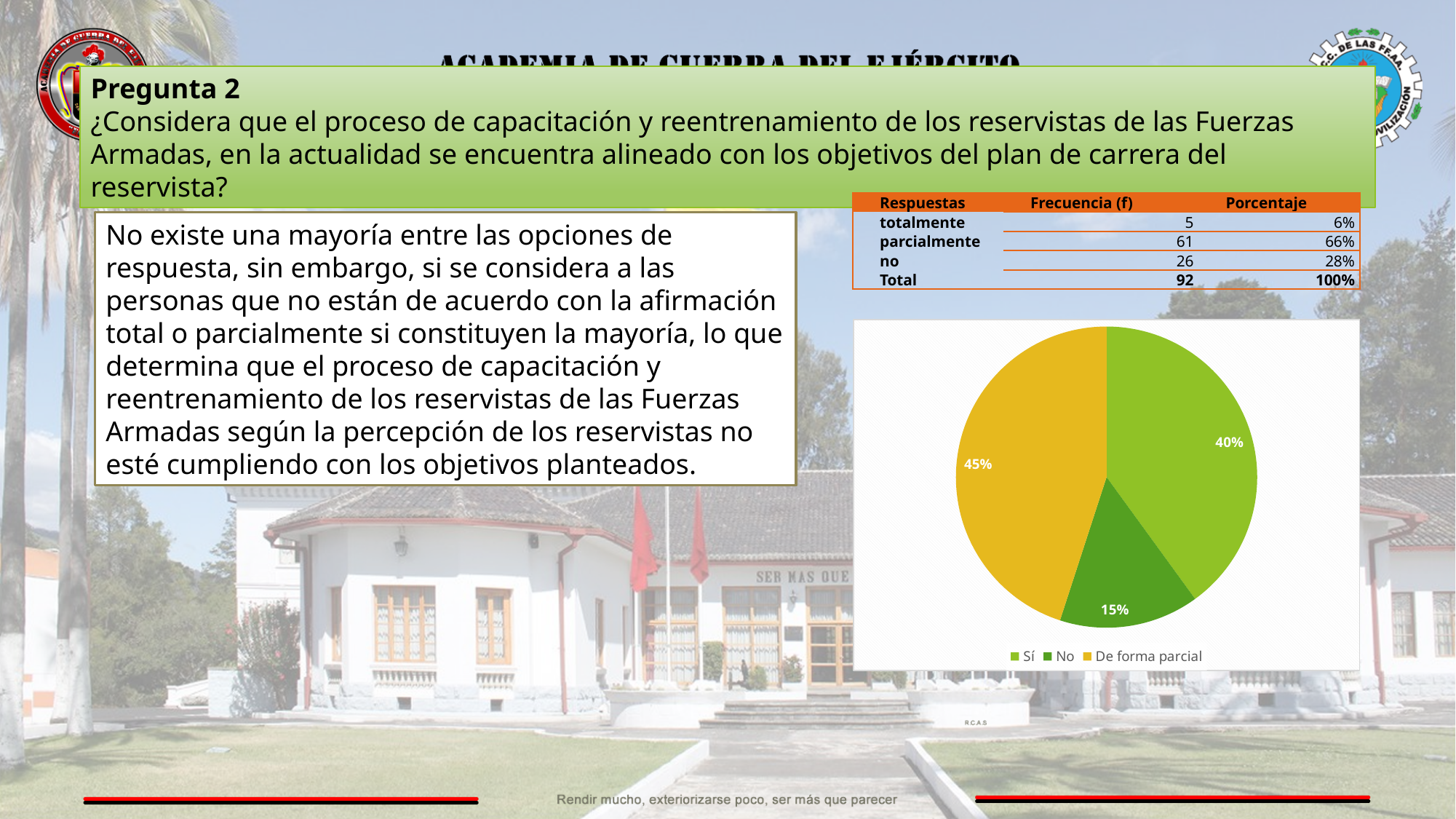
What kind of chart is shown on the slide? pie chart Which slice of the pie chart is the smallest? No What percentage of the pie chart is the 'Sí' slice? 40% Which is larger in the pie chart, the 'Sí' slice or the 'No' slice? Sí What percentage of the pie chart is the 'De forma parcial' slice? 45% What is the difference in percentage points between the 'Sí' slice and the 'No' slice? 25 How many entries does the pie chart legend list? 3 Which slice of the pie chart is the largest? De forma parcial How many slices does the pie chart have? 3 What percentage of the pie chart is the 'No' slice? 15% What is the difference in percentage points between the 'De forma parcial' slice and the 'Sí' slice? 5 What colour is the 'De forma parcial' slice in the pie chart? yellow